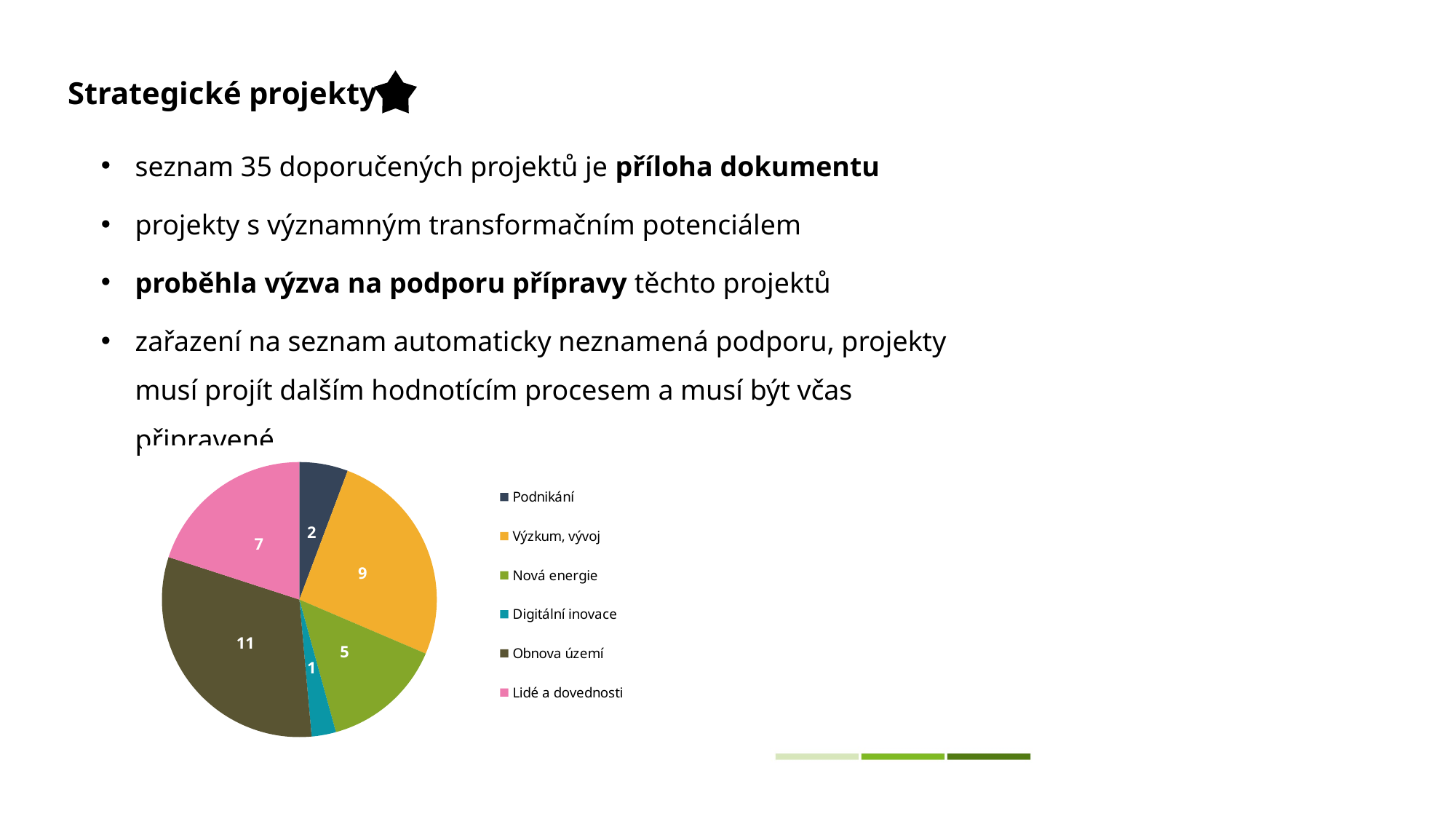
What colour is the Podnikání slice in the pie chart? dark blue-grey What is the value for Obnova území in the pie chart? 11 Which category has the smallest slice in the pie chart? Digitální inovace What is the value for Výzkum, vývoj in the pie chart? 9 How many slices does the pie chart have? 6 What is the total of all slice values in the pie chart? 35 Which category has the largest slice in the pie chart? Obnova území What is the value for Lidé a dovednosti in the pie chart? 7 Which is larger in the pie chart, Výzkum, vývoj or Lidé a dovednosti? Výzkum, vývoj What is the difference between the values for Obnova území and Nová energie? 6 What type of chart is shown on the slide? pie chart What is the value for Digitální inovace in the pie chart? 1